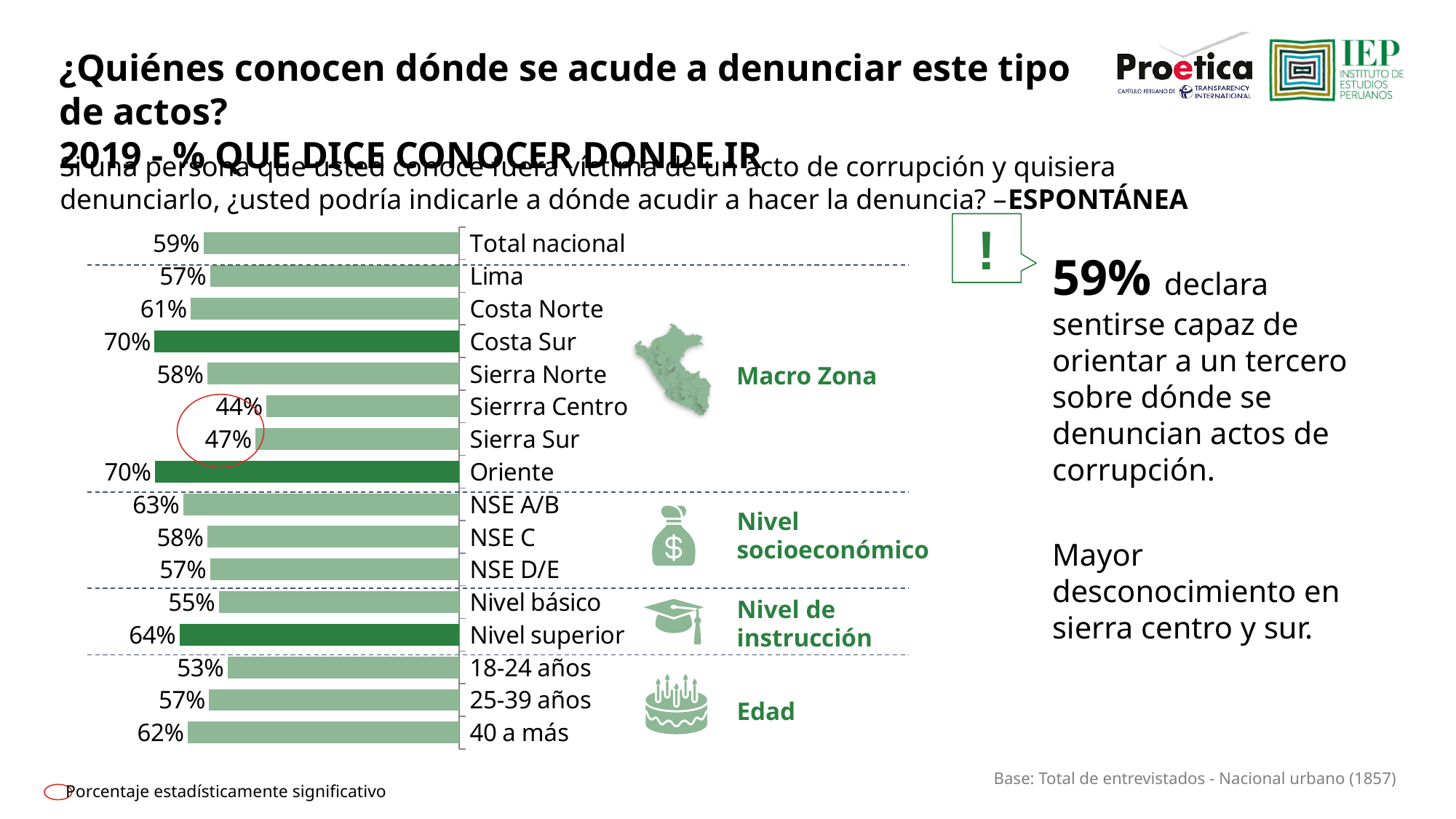
What is the value for the 18-24 años group? 53% Which two categories are circled in red as statistically significant? Sierrra Centro and Sierra Sur Which is larger, the value for 40 a más or for 25-39 años? 40 a más What type of chart is shown on the slide? Bar chart What is the value for Sierra Sur? 47% What is the difference between Costa Sur and Sierrra Centro? 26 percentage points What percentage is shown for Total nacional? 59% What is the difference in percentage points between Nivel superior and Nivel básico? 9 percentage points How many categories (bars) are plotted in the chart? 16 What percentage is shown for NSE A/B? 63% Which has a higher value, Costa Norte or Lima? Costa Norte Which category has the lowest percentage in the chart? Sierrra Centro